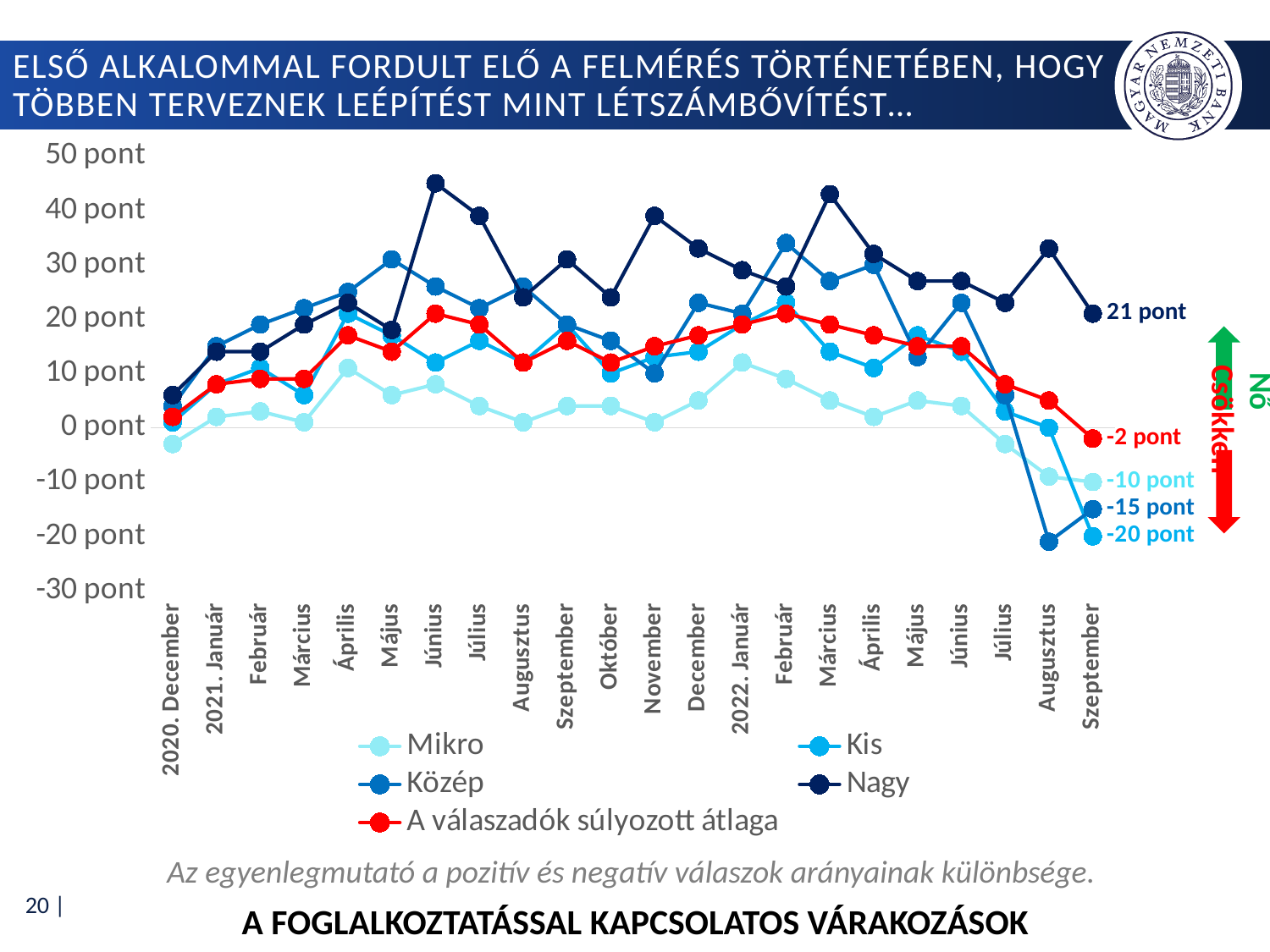
What is the value for Nagy in 2022 Szeptember? 21 pont Is the value for Nagy in 2021 Június greater or less than 40 pont? greater Which series has the lowest value in 2022 Szeptember? Kis How many series does the legend list? 5 What is the value for Kis in 2022 Szeptember? -20 pont What kind of chart is shown on the slide? line chart What is the value for Közép in 2022 Szeptember? -15 pont How many months are shown on the x axis? 22 What is the difference between the Nagy and Kis values in 2022 Szeptember? 41 pont Which series has the highest value in 2022 Szeptember? Nagy What is the value for Mikro in 2022 Szeptember? -10 pont What is the value of A válaszadók súlyozott átlaga in 2022 Szeptember? -2 pont